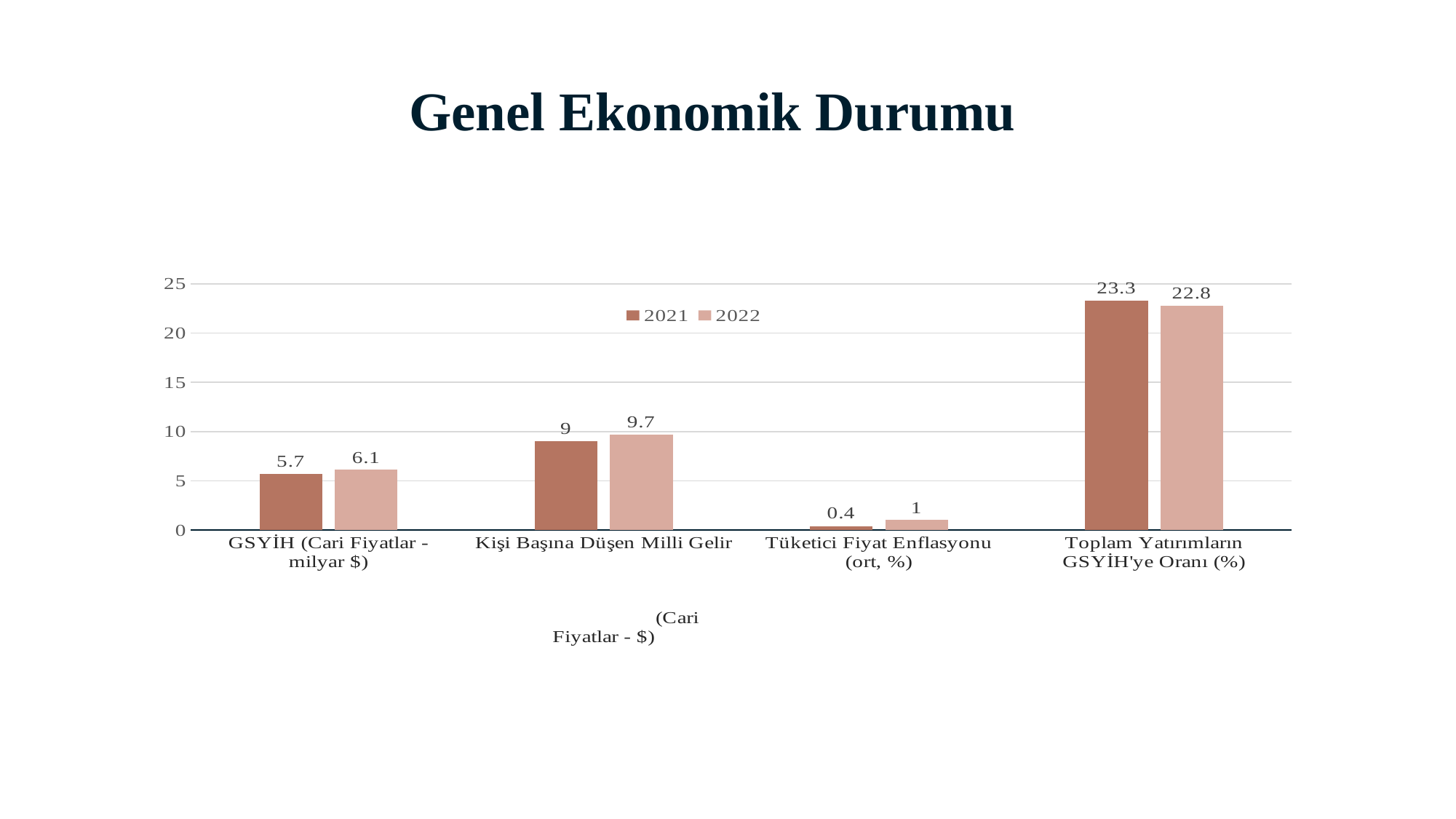
For Toplam Yatırımların GSYİH'ye Oranı (%), which year has the larger value, 2021 or 2022? 2021 Which category has the highest 2021 value? Toplam Yatırımların GSYİH'ye Oranı (%) How many series does the legend list? 2 What is the 2021 value for GSYİH (Cari Fiyatlar - milyar $)? 5.7 What kind of chart is shown on the slide? Bar chart What is the 2021 value for Tüketici Fiyat Enflasyonu (ort, %)? 0.4 What is the title of the slide? Genel Ekonomik Durumu Which category has the lowest 2022 value? Tüketici Fiyat Enflasyonu (ort, %) What is the 2022 value for Toplam Yatırımların GSYİH'ye Oranı (%)? 22.8 What is the difference between the 2022 and 2021 values for Kişi Başına Düşen Milli Gelir? 0.7 What is the 2022 value for Kişi Başına Düşen Milli Gelir? 9.7 How many categories are shown on the x axis? 4